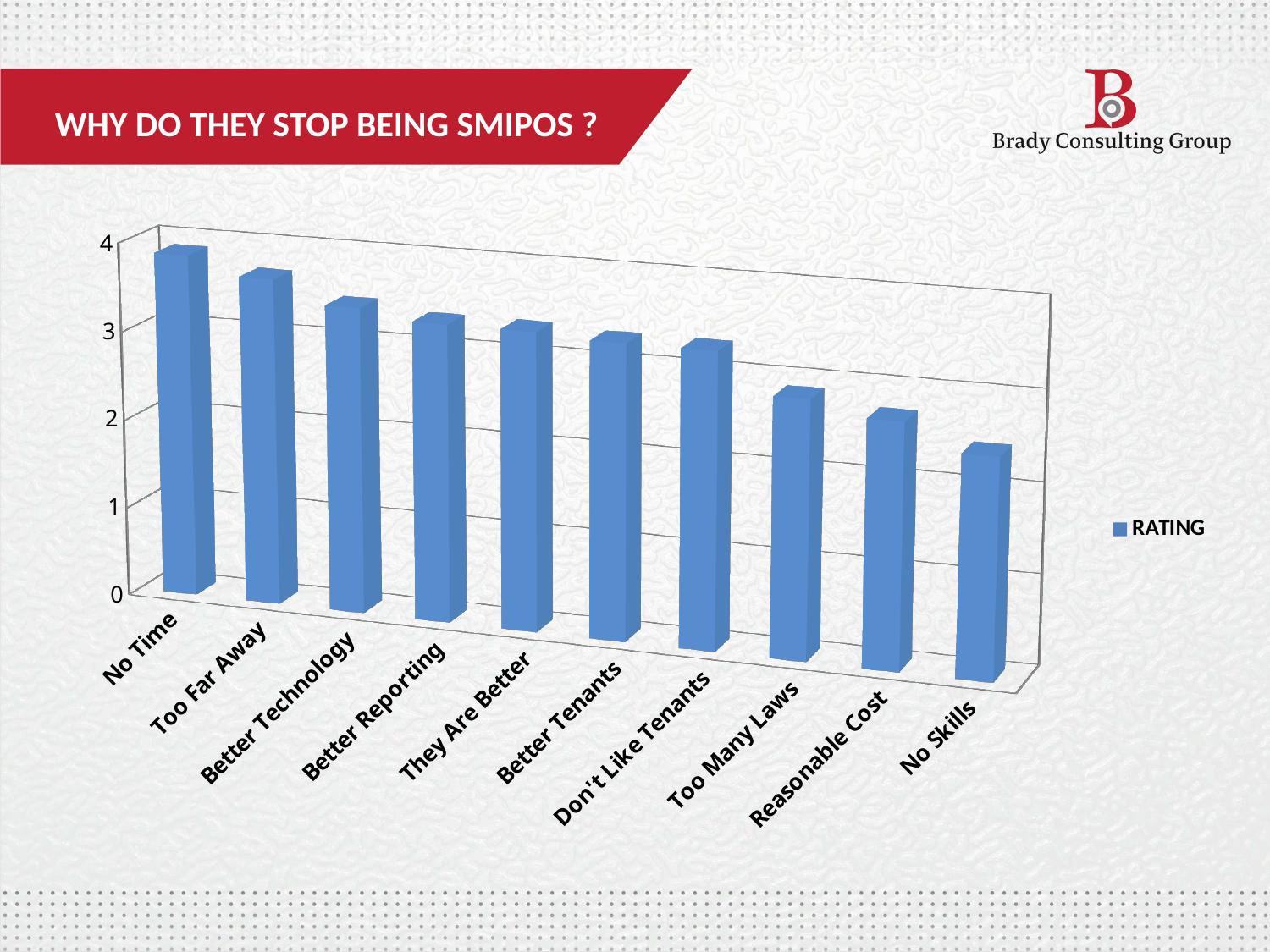
Is the value for No Time greater or less than 3? greater Which category has the highest rating? No Time Do the values rise or fall moving from left to right along the x axis? fall What kind of chart is shown on the slide? bar chart Which category has the lowest rating? No Skills How many series does the chart's legend list? 1 Is the value for Too Many Laws greater or less than 2? greater Which is larger, the value for Too Far Away or the value for Too Many Laws? Too Far Away What is the name of the series shown in the chart's legend? RATING How many categories are shown on the x axis of the chart? 10